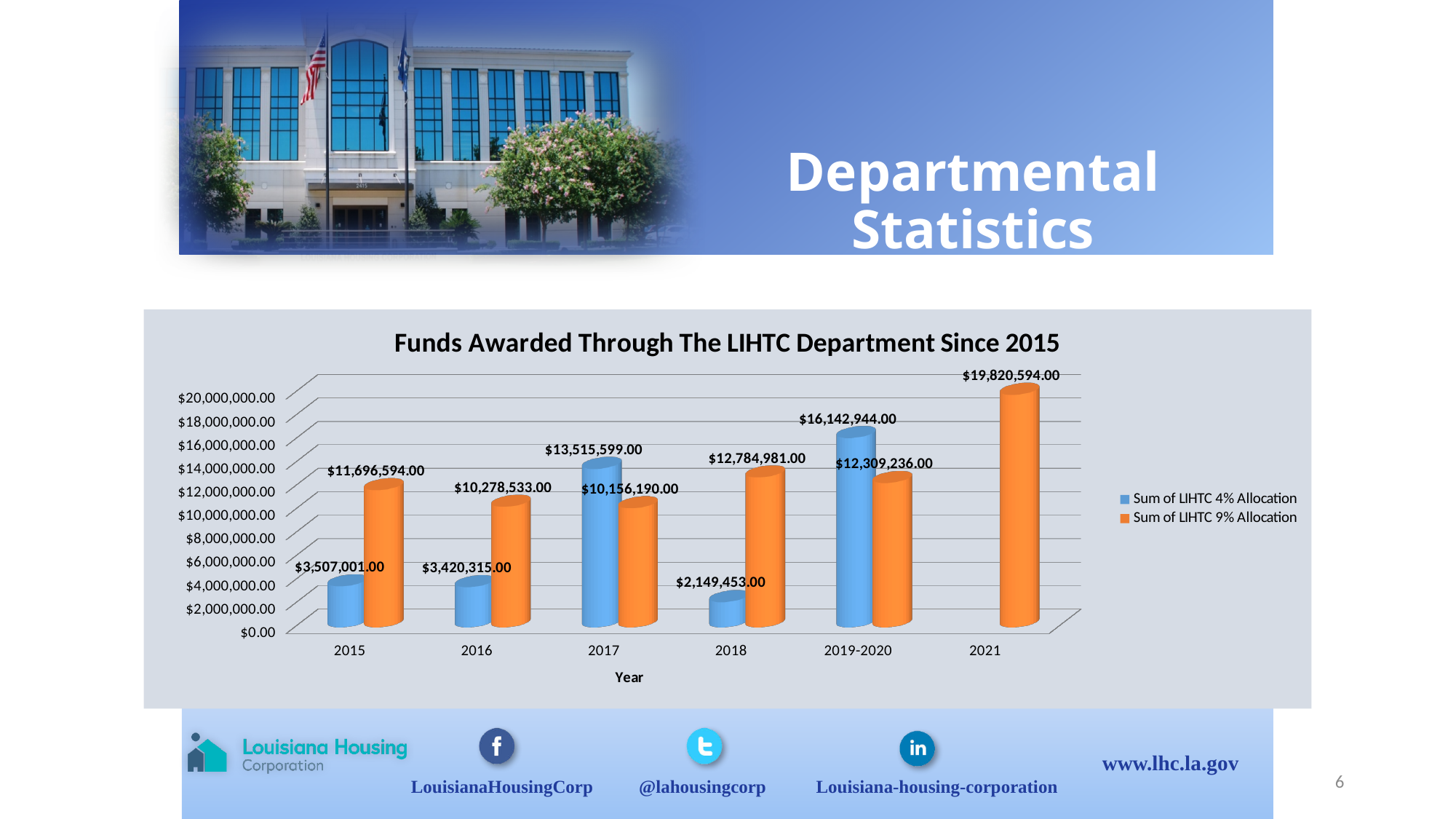
What is the value of the Sum of LIHTC 9% Allocation for 2021? $19,820,594.00 What is the value of the Sum of LIHTC 9% Allocation for 2018? $12,784,981.00 How many series does the legend list? 2 Which year has the lowest Sum of LIHTC 4% Allocation? 2018 What is the value of the Sum of LIHTC 4% Allocation for 2015? $3,507,001.00 What is the difference between the Sum of LIHTC 4% Allocation and the Sum of LIHTC 9% Allocation in 2017? $3,359,409.00 Which year has the highest Sum of LIHTC 9% Allocation? 2021 What is the value of the Sum of LIHTC 4% Allocation for 2019-2020? $16,142,944.00 In 2016, which is larger: the Sum of LIHTC 4% Allocation or the Sum of LIHTC 9% Allocation? Sum of LIHTC 9% Allocation How many year categories are shown on the x axis? 6 What is the title of the chart? Funds Awarded Through The LIHTC Department Since 2015 What kind of chart is shown on the slide? Bar chart